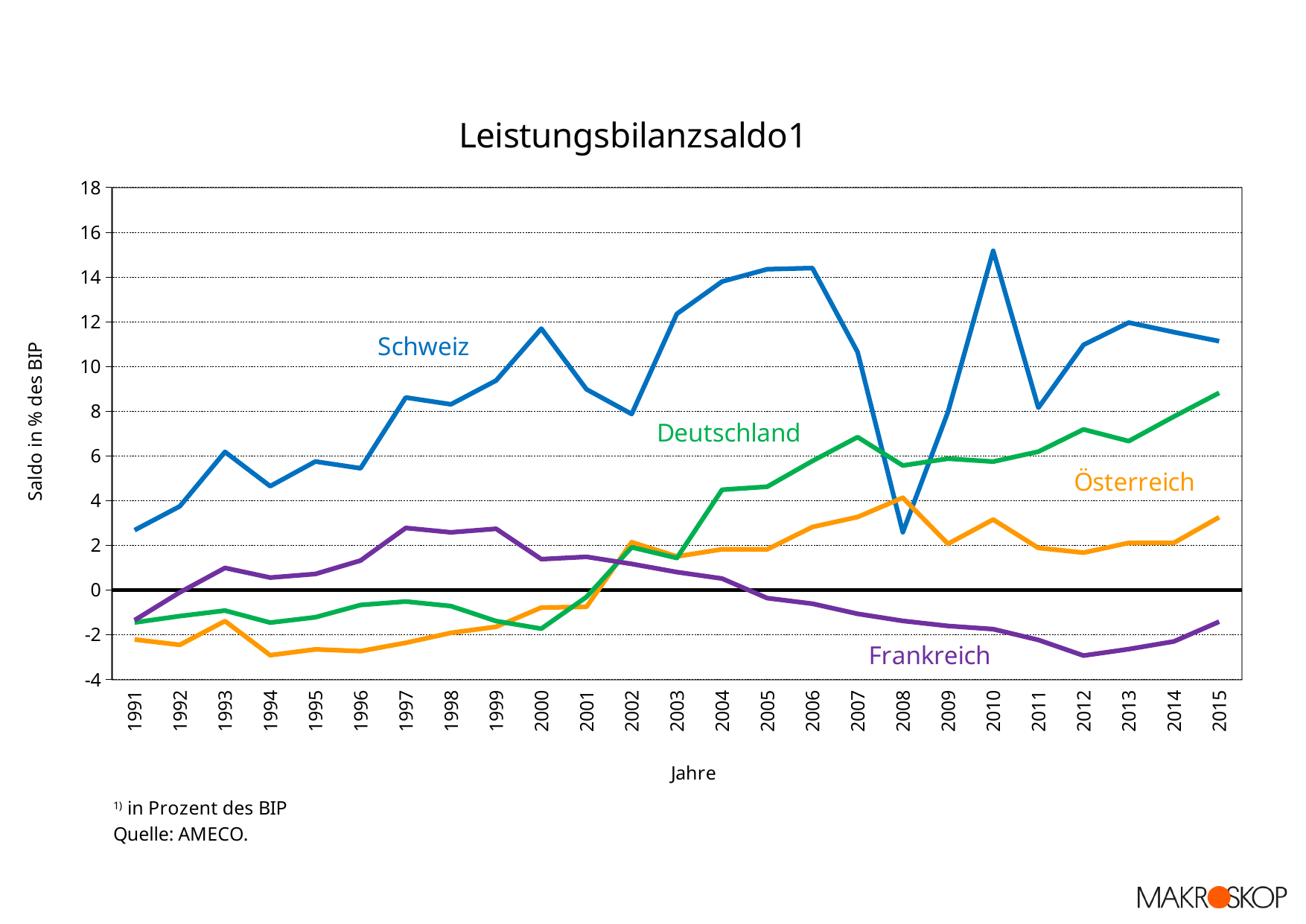
Is the value for Schweiz in 2008 greater or less than 4? less Which country has the highest value in 2010? Schweiz How many series (countries) are plotted in the chart? 4 Does the value for Frankreich rise or fall between 1997 and 2012? fall How many years are shown on the x axis of the chart? 25 In 2008, which is larger: the value for Schweiz or the value for Deutschland? Deutschland Is the value for Deutschland in 2015 greater or less than 8? greater Is the value for Frankreich in 2012 greater or less than -2? less What is the label of the y axis? Saldo in % des BIP What kind of chart is shown on the slide? line chart Which country has the lowest value in 2015? Frankreich